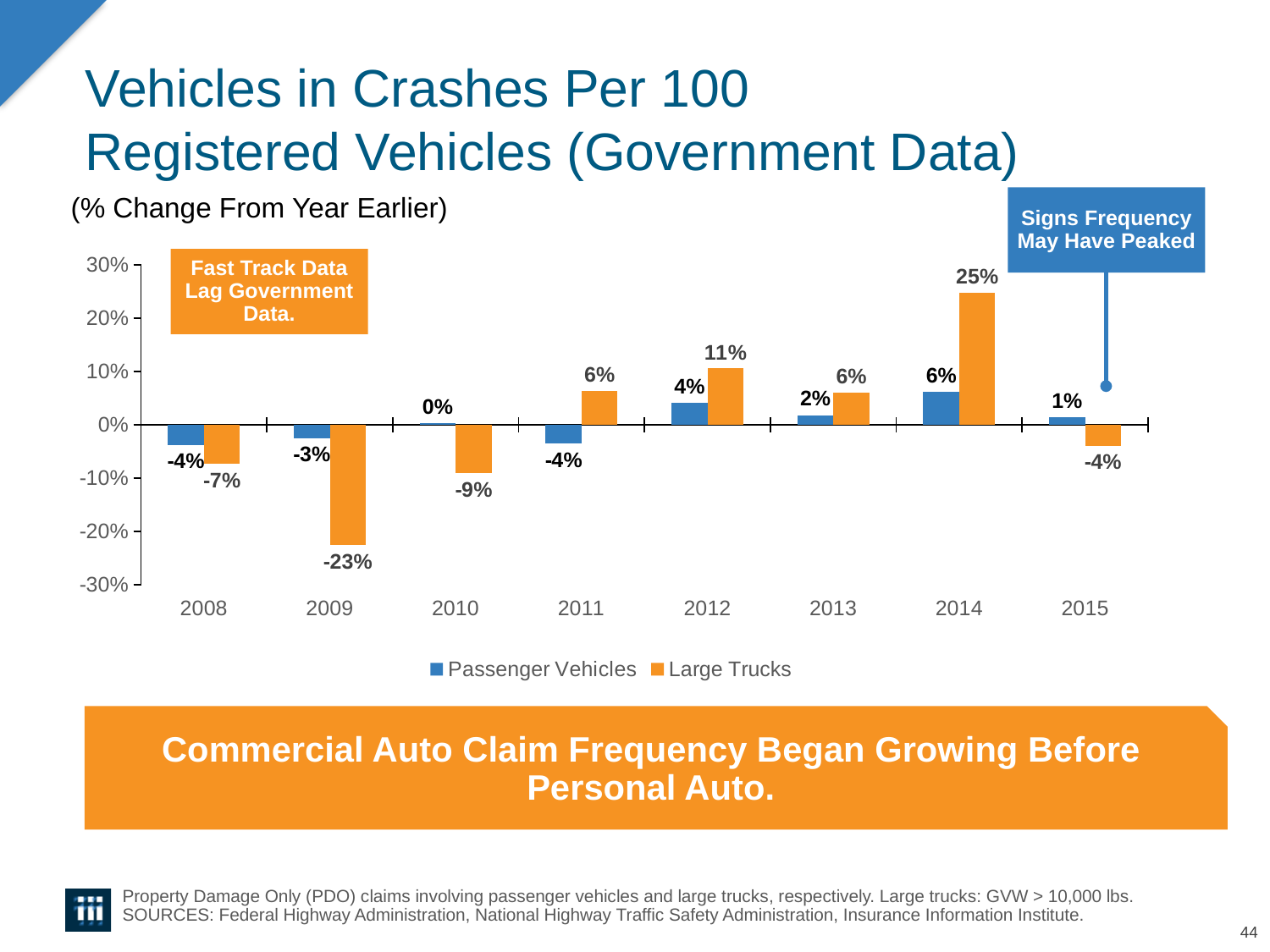
What is the value for Passenger Vehicles in 2012? 4% How many years are shown on the x axis? 8 How many series does the legend list? 2 In which year is the Passenger Vehicles value the highest? 2014 What is the difference between the Large Trucks and Passenger Vehicles values in 2014? 19 percentage points In which year is the Large Trucks value the lowest? 2009 In which year is the Large Trucks value the highest? 2014 Which series has the larger value in 2015, Passenger Vehicles or Large Trucks? Passenger Vehicles What is the value for Large Trucks in 2009? -23% What kind of chart is shown on the slide? Bar chart What is the value for Passenger Vehicles in 2010? 0% What is the value for Large Trucks in 2014? 25%